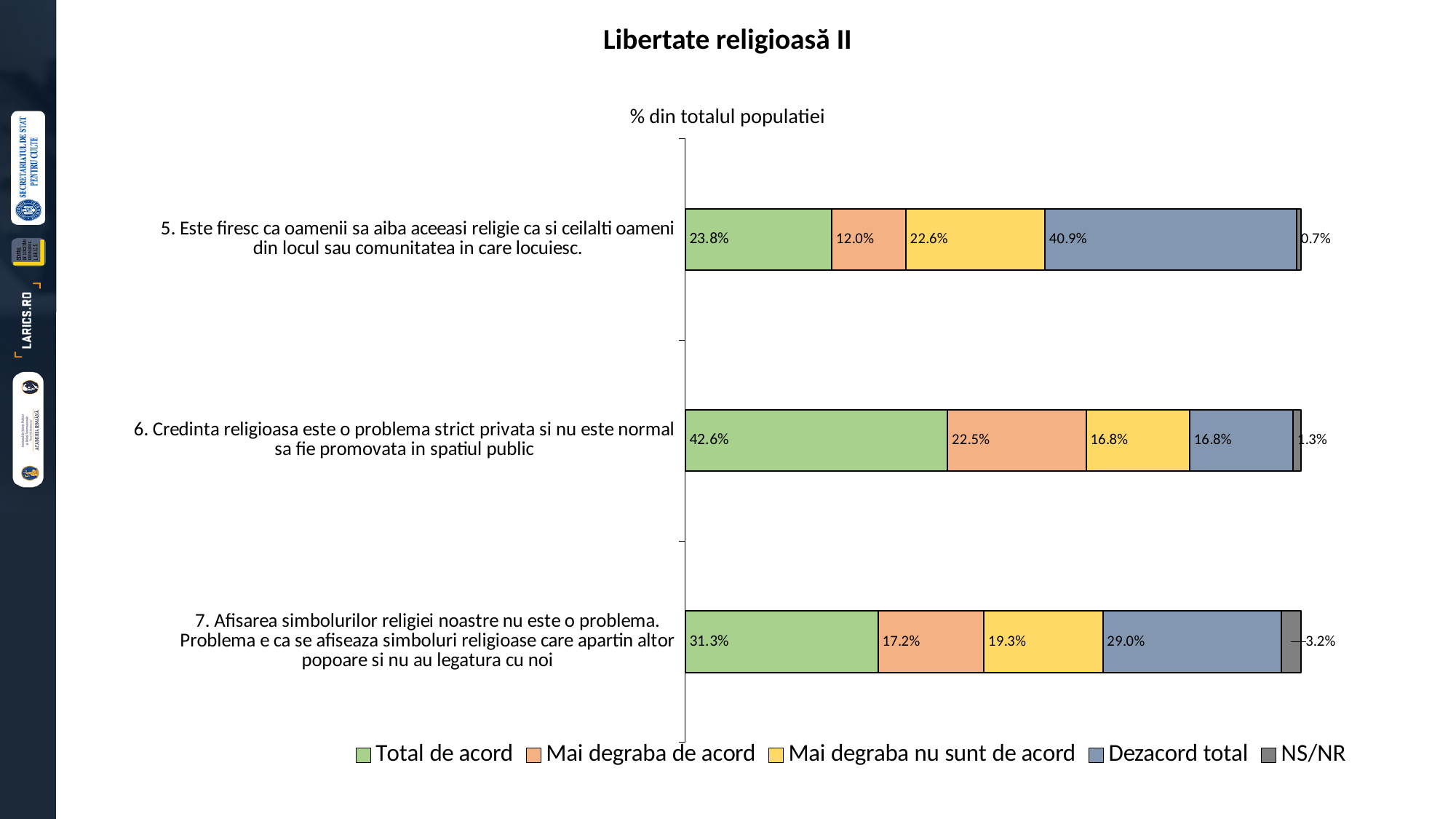
How many series does the legend list? 5 What is the 'Total de acord' value for statement 6 (Credinta religioasa este o problema strict privata...)? 42.6% What is the 'NS/NR' value for statement 7 (Afisarea simbolurilor religiei noastre nu este o problema...)? 3.2% What is the subtitle shown above the chart? % din totalul populatiei Which is larger for statement 7: 'Mai degraba de acord' or 'Mai degraba nu sunt de acord'? Mai degraba nu sunt de acord Which statement has the highest 'Total de acord' value? 6. Credinta religioasa este o problema strict privata si nu este normal sa fie promovata in spatiul public Which statement has the lowest 'NS/NR' value? 5. Este firesc ca oamenii sa aiba aceeasi religie ca si ceilalti oameni din locul sau comunitatea in care locuiesc. What is the 'Dezacord total' value for statement 5 (Este firesc ca oamenii sa aiba aceeasi religie...)? 40.9% How many statements (categories) are plotted in the chart? 3 What is the total of all segments in the bar for statement 6? 100.0% What kind of chart is shown on the slide? Stacked bar chart What is the difference between the 'Dezacord total' values for statement 5 and statement 7? 11.9%